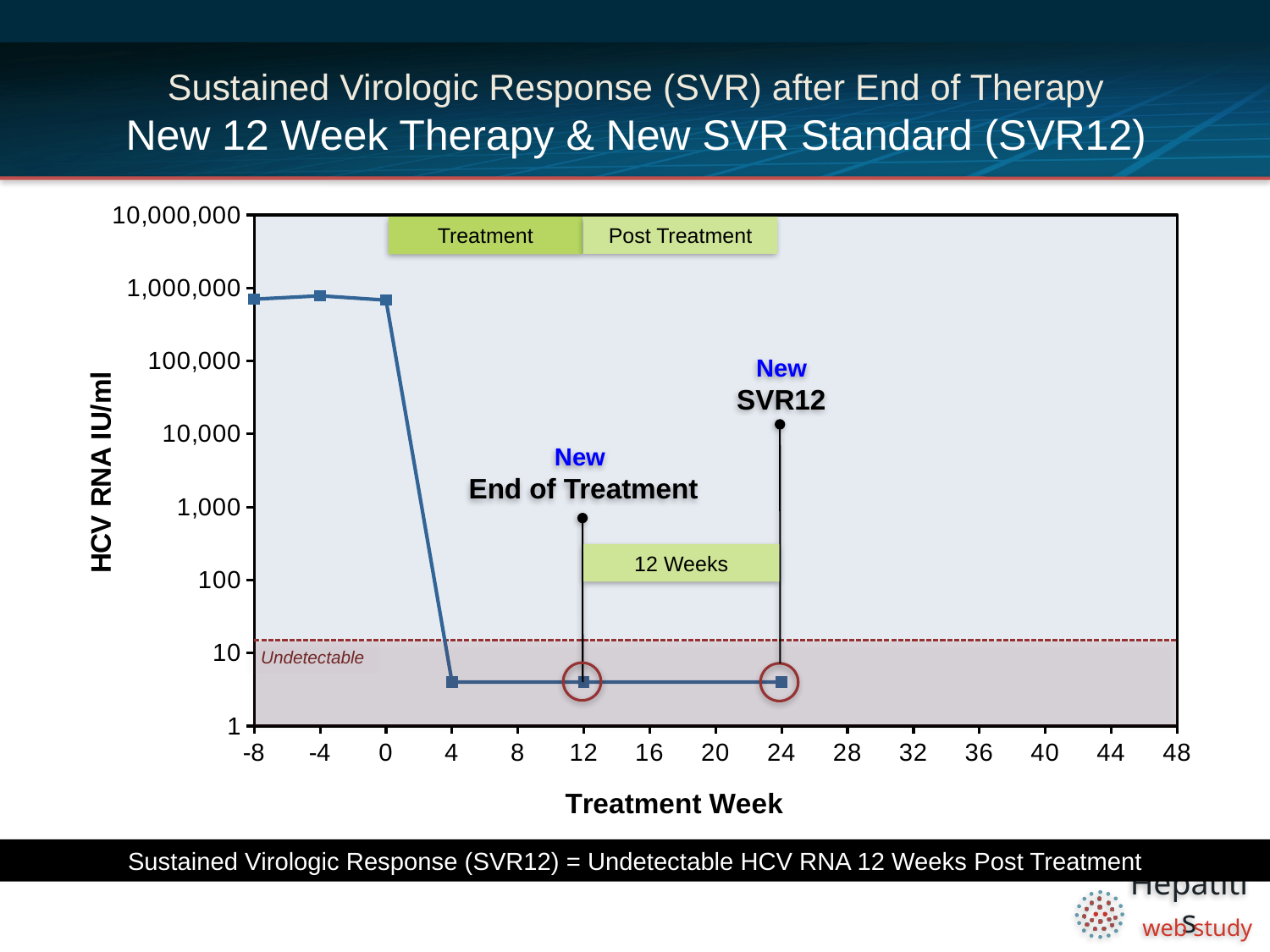
At which treatment week is the 'New SVR12' marker placed? 24 Which has the larger HCV RNA value, treatment week 0 or treatment week 4? treatment week 0 What is the title of the x axis? Treatment Week Does the HCV RNA value rise or fall between treatment week 0 and treatment week 4? fall Is the HCV RNA value at treatment week -4 greater or less than 100,000? greater Is the HCV RNA value at treatment week 12 greater or less than 10? less How many data points are plotted on the HCV RNA line? 6 Is the HCV RNA value at treatment week 24 greater or less than 100? less What kind of chart is shown on the slide? line chart Which has the larger HCV RNA value, treatment week -8 or treatment week 24? treatment week -8